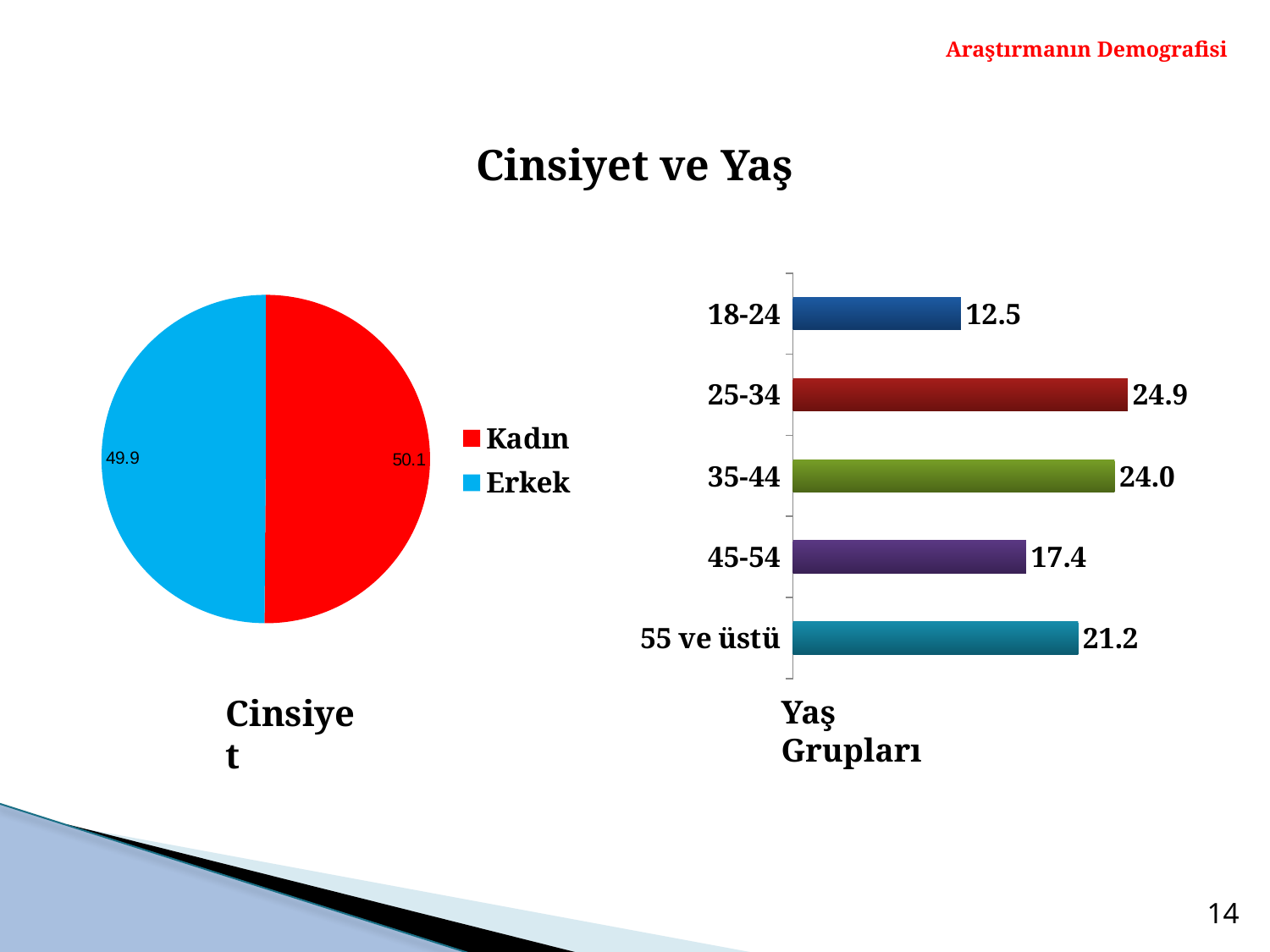
What kind of chart is the Cinsiyet chart on the left? pie chart In the Cinsiyet pie chart, what is the value for Erkek? 49.9 In the Yaş Grupları chart, what is the difference between the values for 35-44 and 45-54? 6.6 In the Yaş Grupları chart, which age group has the highest value? 25-34 What kind of chart is the Yaş Grupları chart on the right? bar chart In the Cinsiyet pie chart, how many slices are there? 2 In the Yaş Grupları chart, what is the value for 25-34? 24.9 In the Yaş Grupları chart, which age group has the lowest value? 18-24 In the Cinsiyet pie chart, which colour represents Erkek? blue In the Yaş Grupları chart, which is larger, the value for 45-54 or the value for 55 ve üstü? 55 ve üstü In the Cinsiyet pie chart, what is the value for Kadın? 50.1 In the Yaş Grupları chart, what is the value for 55 ve üstü? 21.2